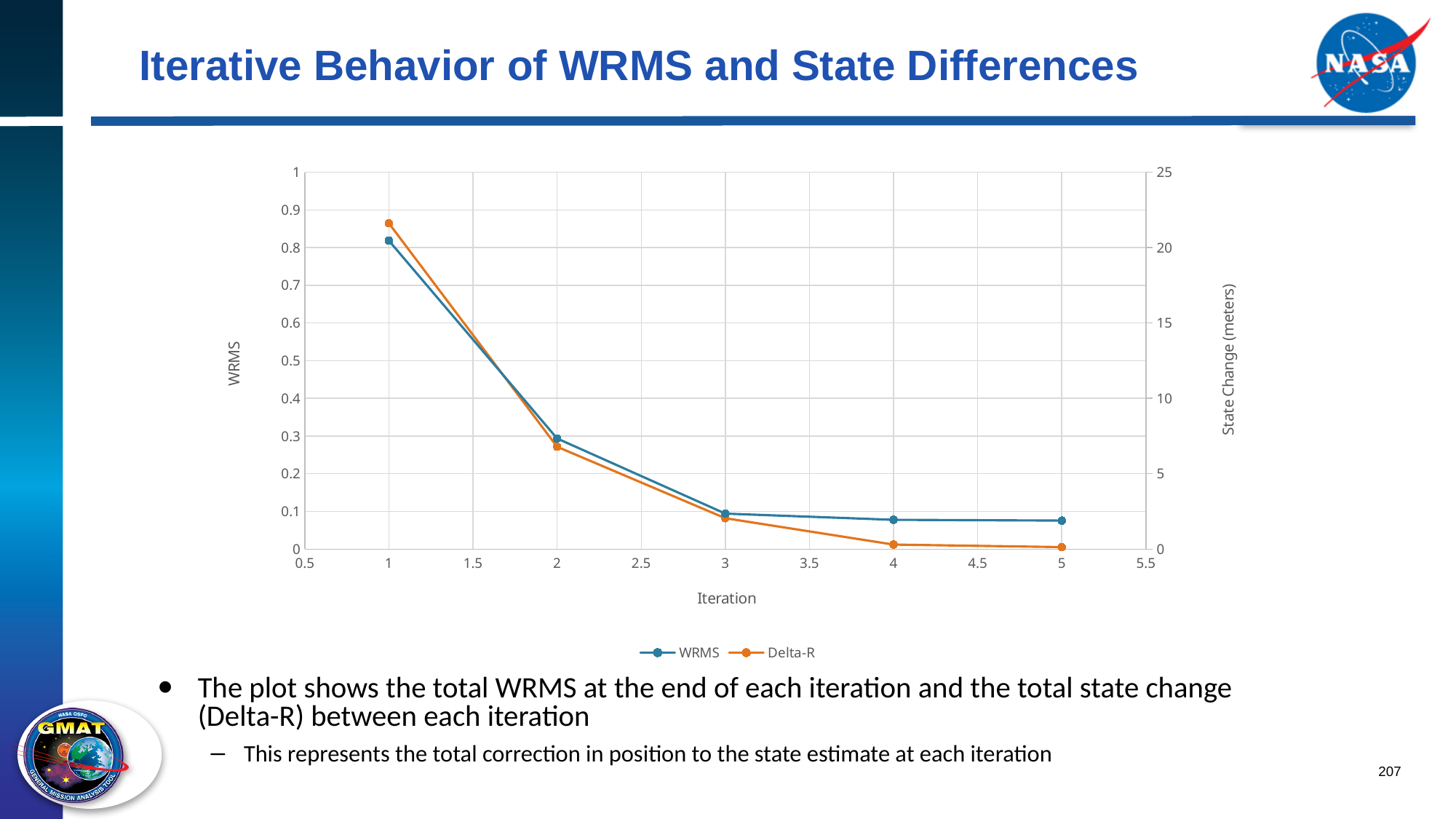
What kind of chart is shown on the slide? line chart At which iteration is the WRMS value highest? 1 Is the WRMS value at iteration 2 greater or less than 0.4? less How many series does the legend list? 2 What is the title of the right-hand vertical axis? State Change (meters) Which is larger, the WRMS value at iteration 1 or at iteration 3? iteration 1 At which iteration is the Delta-R value highest? 1 Is the Delta-R value at iteration 1 greater or less than 20? greater Is the WRMS value at iteration 1 greater or less than 0.7? greater Do the WRMS values rise or fall as the iteration number increases? fall How many iterations are plotted for the WRMS series? 5